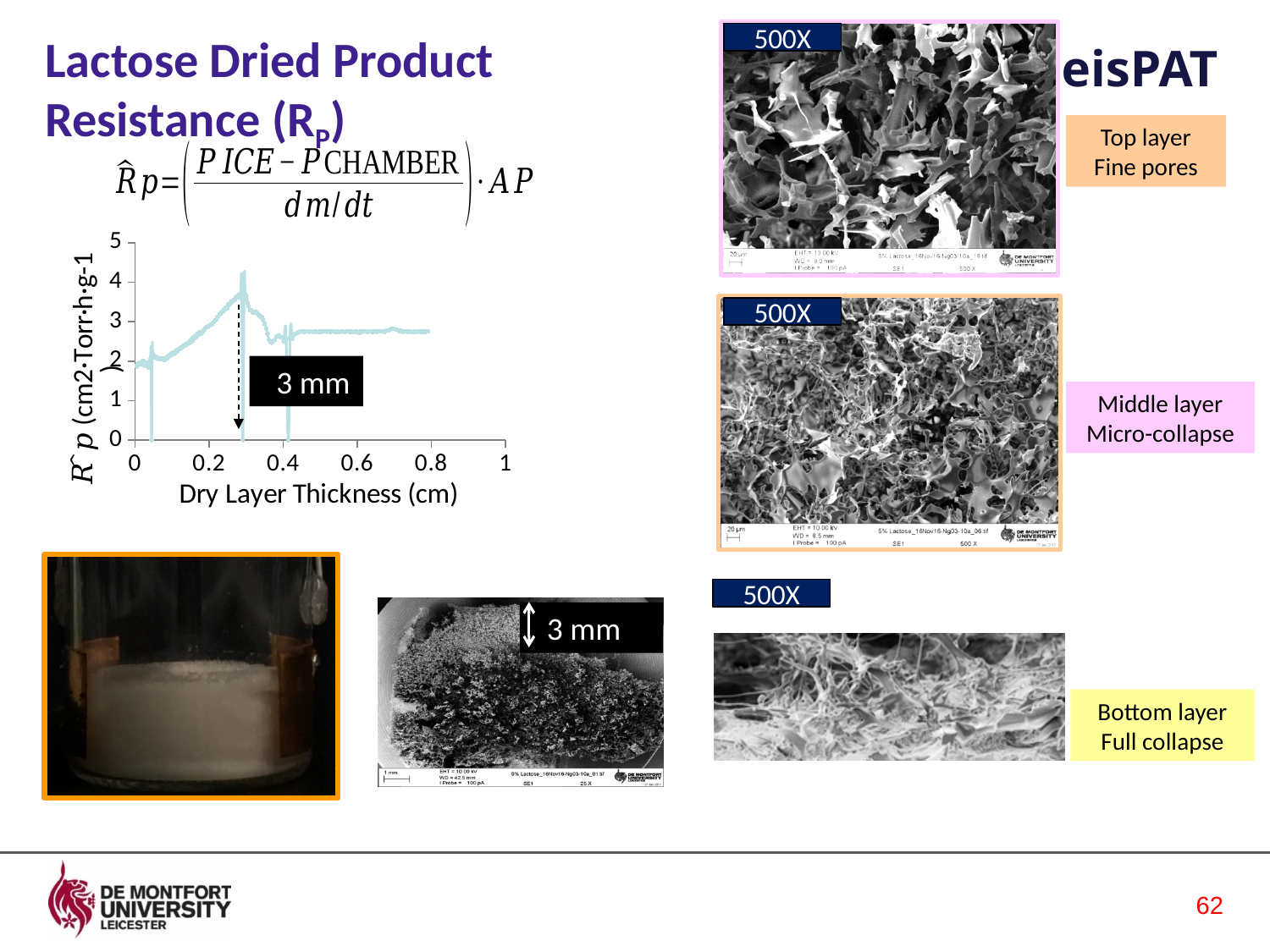
Is the value of Rp at a dry layer thickness of 0.6 cm greater or less than 2? greater Does Rp rise or fall as dry layer thickness increases from 0.3 cm to 0.4 cm? fall Is the value of Rp at a dry layer thickness of 0.8 cm greater or less than 4? less What kind of chart is shown on the slide? line chart What is the label of the x axis of the chart? Dry Layer Thickness (cm) What is the highest value shown on the y axis of the chart? 5 Does Rp rise or fall as dry layer thickness increases from 0.1 cm to 0.3 cm? rise How many data series are plotted in the chart? 1 Is the value of Rp at a dry layer thickness of 0.1 cm greater or less than 3? less What annotation label is placed next to the dashed arrow marking the peak of the curve? 3 mm Is Rp higher at a dry layer thickness of 0.3 cm or at 0.1 cm? 0.3 cm